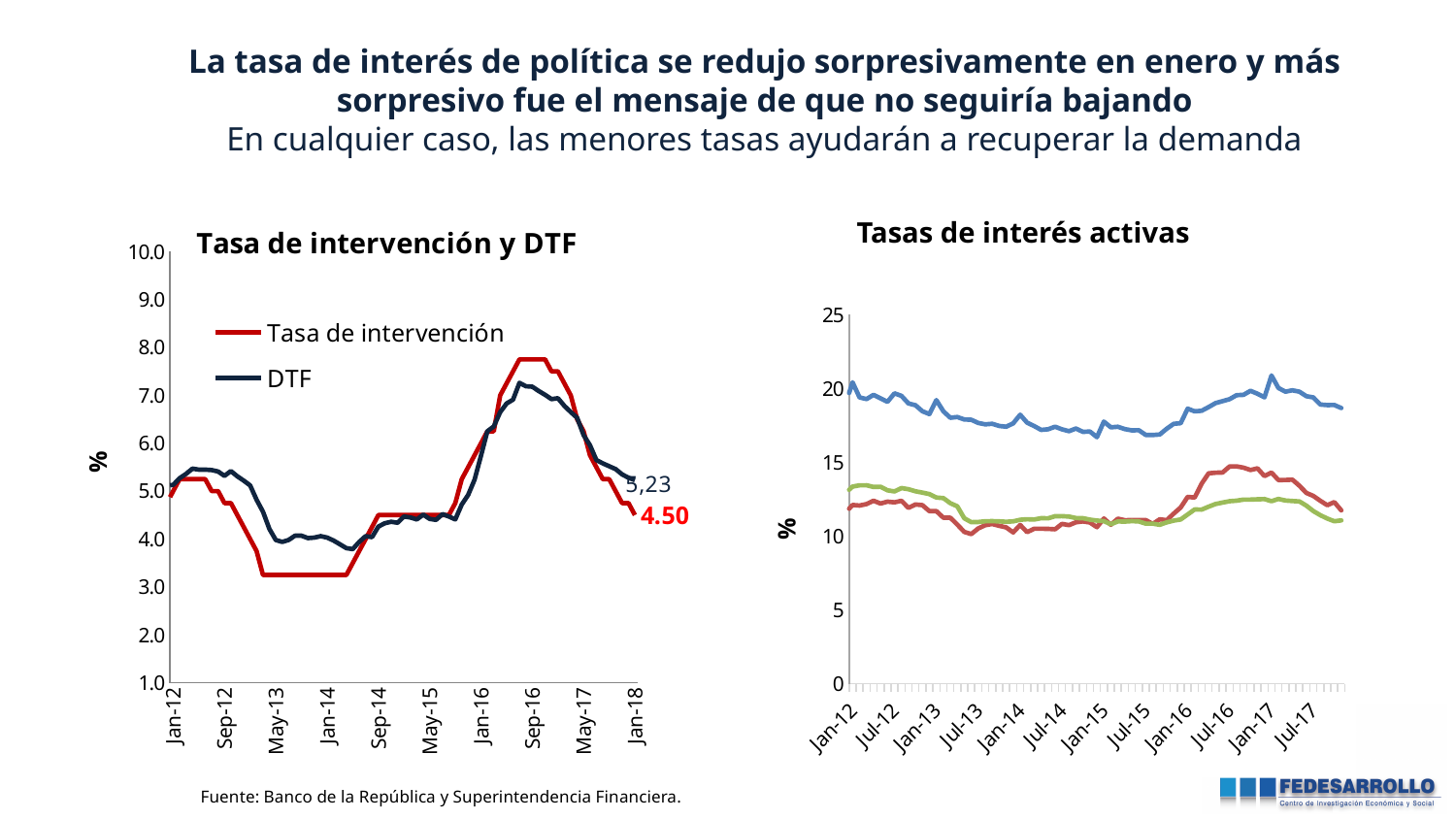
On the chart 'Tasa de intervención y DTF', how many series does the legend list? 2 On the chart 'Tasa de intervención y DTF', which series has the higher value at the end of the period, Tasa de intervención or DTF? DTF On the chart 'Tasas de interés activas', how many lines are plotted? 3 On the chart 'Tasa de intervención y DTF', is the Tasa de intervención value around Sep-16 greater or less than 7.0? greater On the chart 'Tasa de intervención y DTF', what is the last labelled value of the DTF series? 5,23 On the chart 'Tasa de intervención y DTF', does the Tasa de intervención rise or fall between Sep-16 and Jan-18? Fall On the chart 'Tasa de intervención y DTF', what colour is the Tasa de intervención line? Red On the chart 'Tasa de intervención y DTF', what is the last labelled value of the Tasa de intervención series? 4.50 On the chart 'Tasas de interés activas', is the value of the blue line at Jan-12 greater or less than 15? greater On the chart 'Tasa de intervención y DTF', is the Tasa de intervención value around May-13 greater or less than 4.0? less On the chart 'Tasa de intervención y DTF', what is the difference between the final labelled DTF value and the final labelled Tasa de intervención value? 0.73 What kind of chart is 'Tasa de intervención y DTF'? Line chart